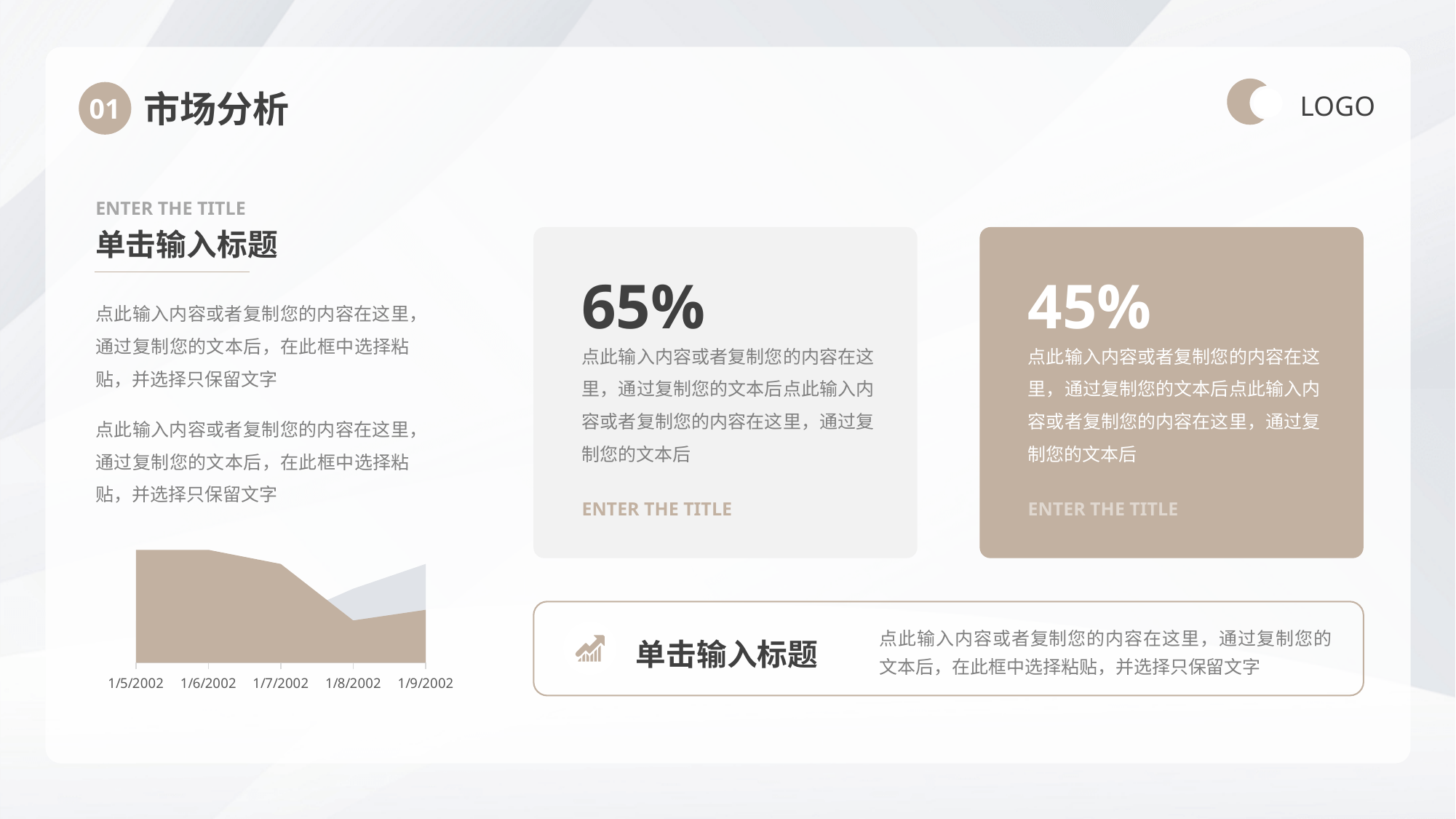
What is the last date label on the x axis of the area chart? 1/9/2002 On which date does the tan (brown) area in the chart reach its lowest point? 1/8/2002 How many dates are labelled on the x axis of the area chart? 5 What is the first date label on the x axis of the area chart? 1/5/2002 Does the tan area in the chart rise or fall between 1/7/2002 and 1/8/2002? fall What kind of chart is shown at the bottom left of the slide? area chart Does the light grey area in the chart rise or fall between 1/8/2002 and 1/9/2002? rise What colour is the front (lower) filled area in the chart? tan (brown) How many differently coloured filled areas are visible in the area chart? 2 Does the tan area in the chart rise or fall between 1/8/2002 and 1/9/2002? rise In the area chart, is the tan area higher at 1/6/2002 or at 1/8/2002? 1/6/2002